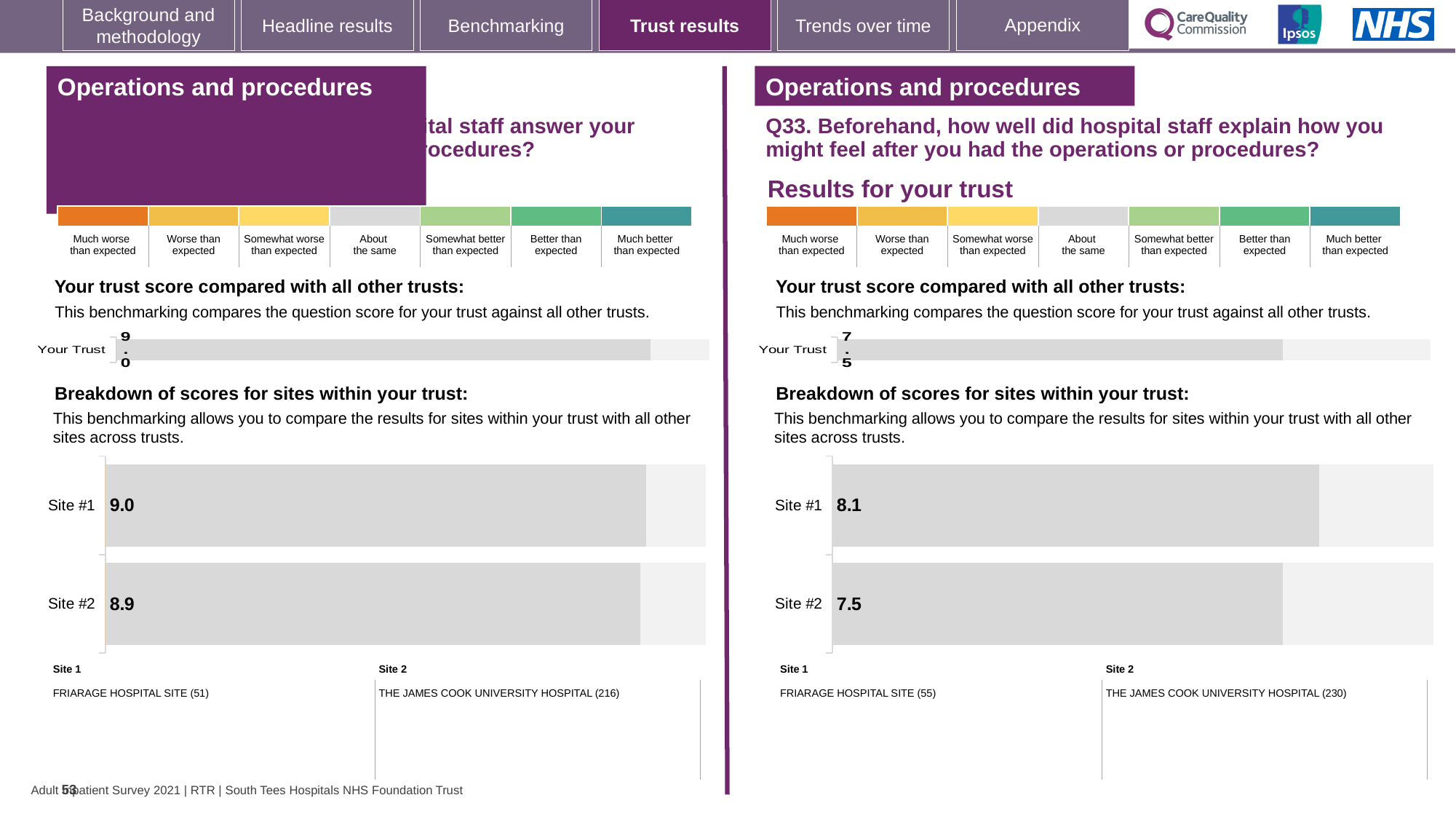
On the left-hand 'Breakdown of scores for sites within your trust' chart, what is the score for Site #2? 8.9 On the right-hand (Q33) side, which hospital is listed as Site 1? FRIARAGE HOSPITAL SITE (55) On the left-hand site breakdown chart, what is the difference between the Site #1 and Site #2 scores? 0.1 On the right-hand (Q33) site breakdown chart, which site has the higher score? Site #1 On the right-hand (Q33) 'Your trust score compared with all other trusts' chart, what is the score for Your Trust? 7.5 On the right-hand (Q33) 'Breakdown of scores for sites within your trust' chart, what is the score for Site #1? 8.1 On the right-hand (Q33) site breakdown chart, what is the difference between the Site #1 and Site #2 scores? 0.6 What kind of chart is the right-hand (Q33) site breakdown chart? Bar chart On the left-hand 'Breakdown of scores for sites within your trust' chart, what is the score for Site #1? 9.0 On the left-hand 'Your trust score compared with all other trusts' chart, what is the score for Your Trust? 9.0 On the right-hand (Q33) 'Breakdown of scores for sites within your trust' chart, what is the score for Site #2? 7.5 How many sites are shown on the right-hand (Q33) site breakdown chart? 2